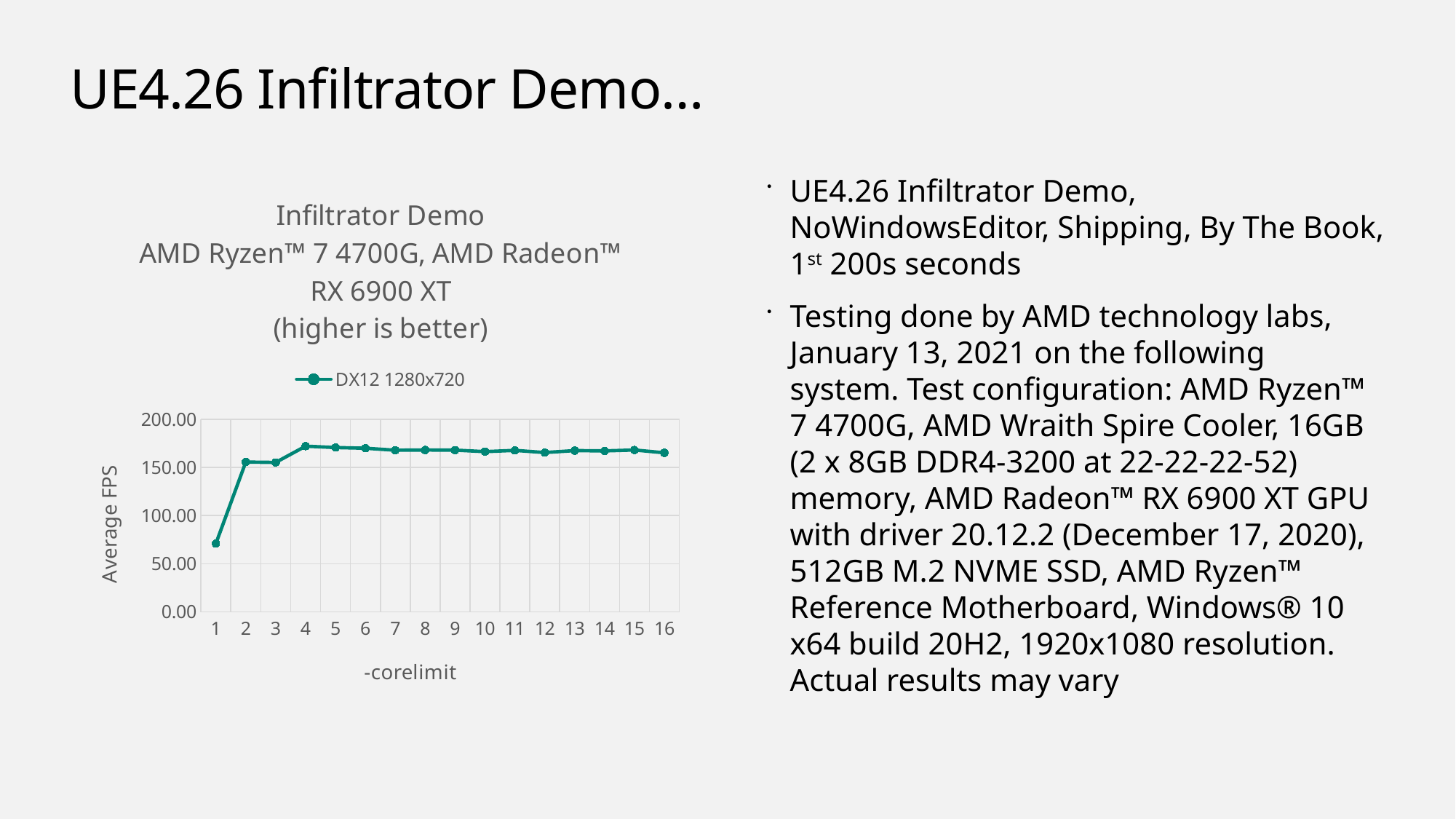
Which -corelimit value has the lowest Average FPS? 1 Does the Average FPS rise or fall from -corelimit 1 to -corelimit 4? rise What kind of chart is shown on the slide? line chart How many -corelimit values are plotted along the x axis? 16 Is the Average FPS at -corelimit 4 greater or less than 200? less How many series does the chart legend list? 1 Is the Average FPS at -corelimit 1 greater or less than 100? less Which has the higher Average FPS, -corelimit 1 or -corelimit 2? -corelimit 2 What is the name of the series shown in the chart legend? DX12 1280x720 What is the label of the y axis? Average FPS Is the Average FPS at -corelimit 16 greater or less than 150? greater